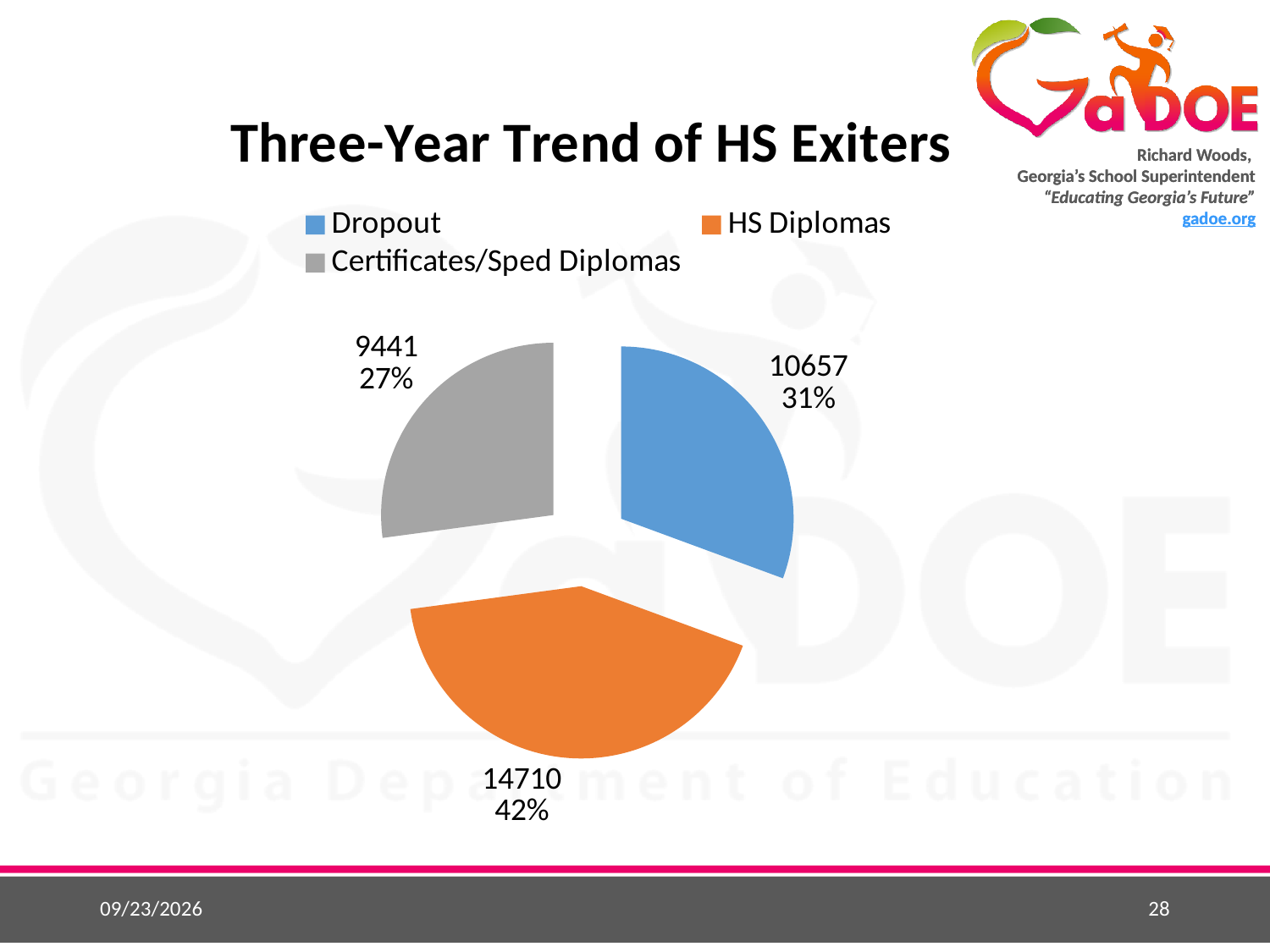
Which category has the smallest slice? Certificates/Sped Diplomas What share of the pie does Dropout represent? 31% What share of the pie does Certificates/Sped Diplomas represent? 27% What type of chart is shown on the slide? pie chart How many categories does the pie chart have? 3 What share of the pie does HS Diplomas represent? 42% What is the title of the chart? Three-Year Trend of HS Exiters What is the value for Certificates/Sped Diplomas? 9441 What is the difference between the HS Diplomas value and the Dropout value? 4053 What is the value for HS Diplomas? 14710 Which category has the largest slice? HS Diplomas What is the value for Dropout? 10657